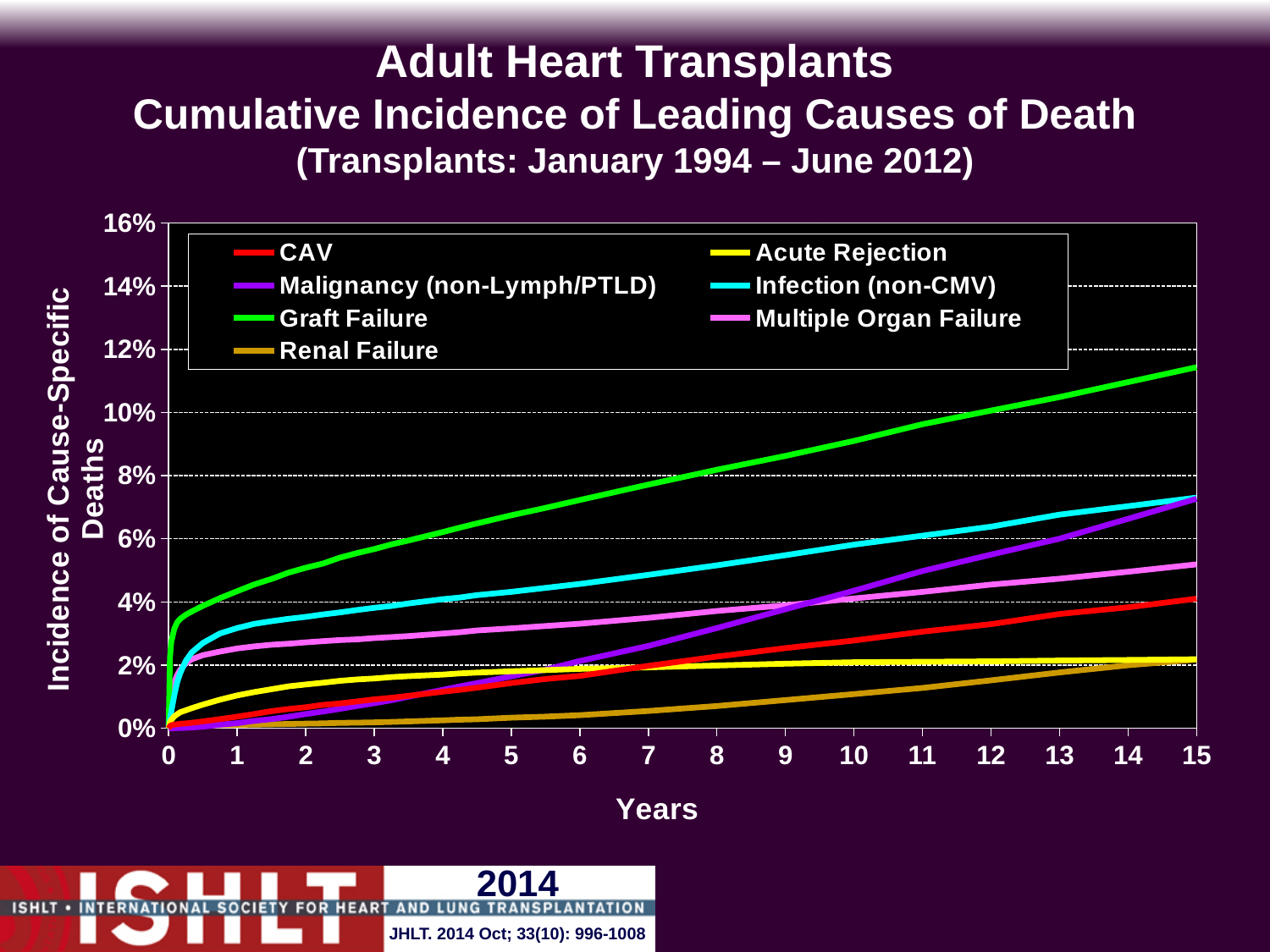
Is the value for Graft Failure at 15 years greater or less than 10%? greater At 15 years, which is larger: Graft Failure or Infection (non-CMV)? Graft Failure What kind of chart is shown on the slide? line chart At 15 years, which is larger: Multiple Organ Failure or CAV? Multiple Organ Failure Is the value for CAV at 15 years greater or less than 6%? less How many series does the legend list? 7 Is the value for Renal Failure at 10 years greater or less than 2%? less What is the label of the x axis? Years Which cause of death has the highest cumulative incidence at 15 years? Graft Failure Does the Graft Failure line rise or fall as years increase? rise